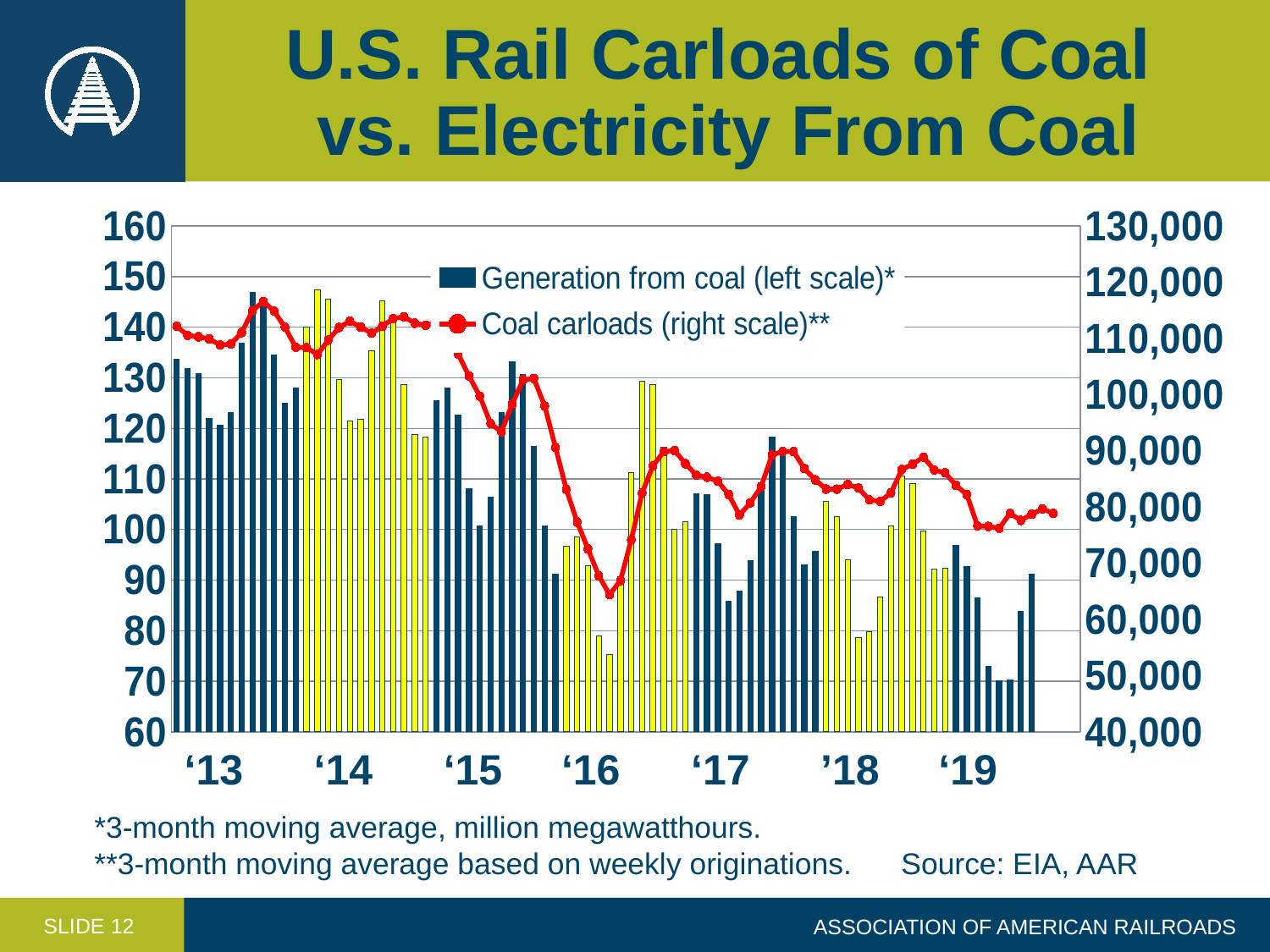
How many series does the legend list? 2 Which series is plotted as bars according to the legend? Generation from coal (left scale)* What kind of chart is shown on the slide? bar and line chart What is the title of the chart? U.S. Rail Carloads of Coal vs. Electricity From Coal How many years are labeled on the x axis? 7 Is the lowest coal carloads value in '16 greater or less than 70,000? less Is the highest generation from coal bar in '13 greater or less than 140? greater Is the coal carloads value at the start of '13 greater or less than 100,000? greater Are coal carloads higher at the start of '13 or at the start of '19? '13 Overall, does generation from coal rise or fall from '13 to '19? fall In which year does the coal carloads line reach its lowest point? '16 Overall, do coal carloads rise or fall from '13 to '19? fall